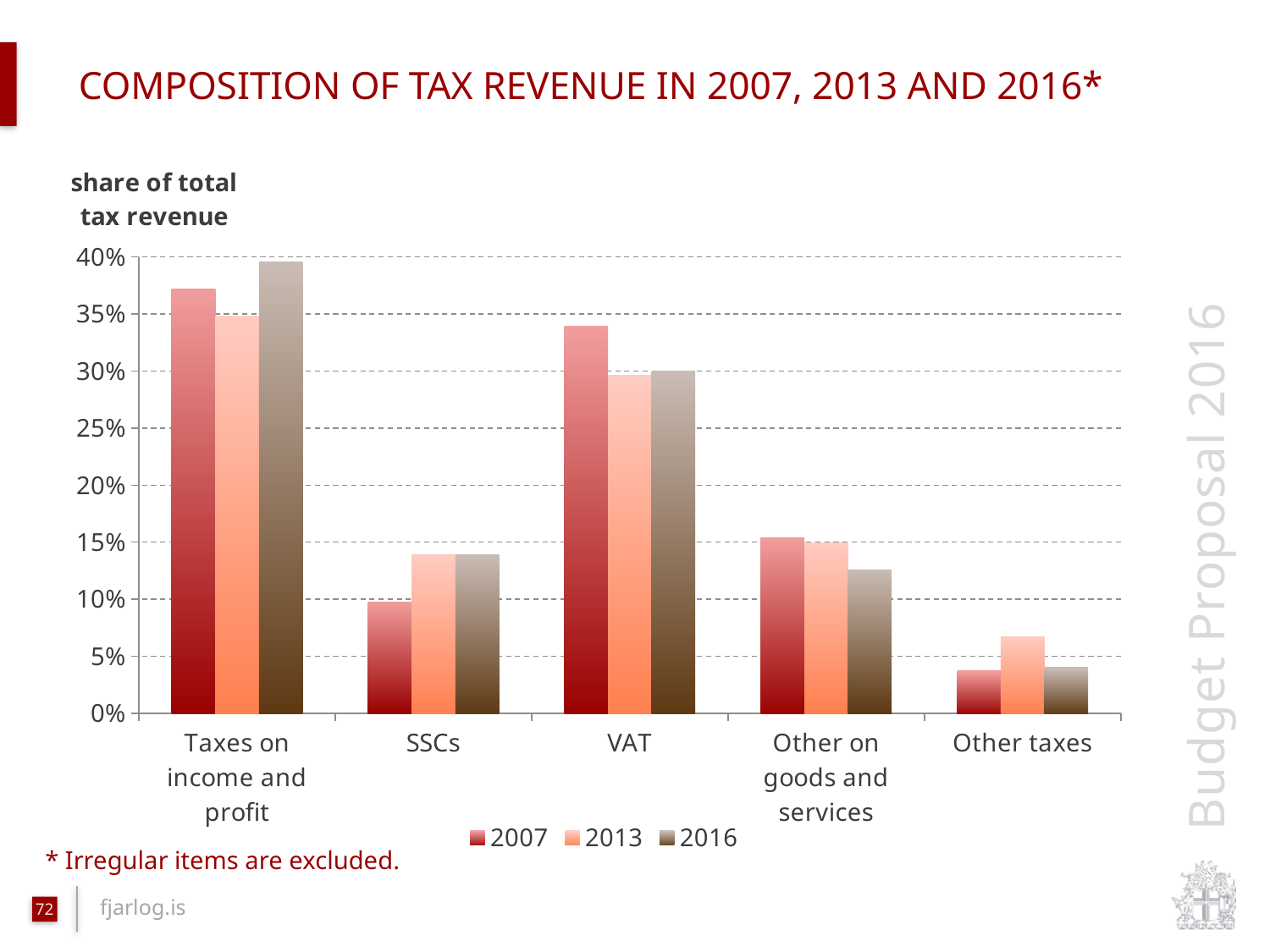
Which category has the highest value for 2016? Taxes on income and profit How many categories are shown on the x axis? 5 What does the label above the y axis say the values represent? share of total tax revenue Is the 2013 value for SSCs greater or less than 10%? greater What are the three entries in the chart legend? 2007, 2013, 2016 Which category has the lowest value for 2007? Other taxes For Taxes on income and profit, which year has the larger value, 2007 or 2013? 2007 How many series does the legend list? 3 What kind of chart is shown on the slide? bar chart For Other taxes, which year has the larger value, 2013 or 2016? 2013 Is the 2007 value for VAT greater or less than 30%? greater Is the 2016 value for Other on goods and services greater or less than 15%? less